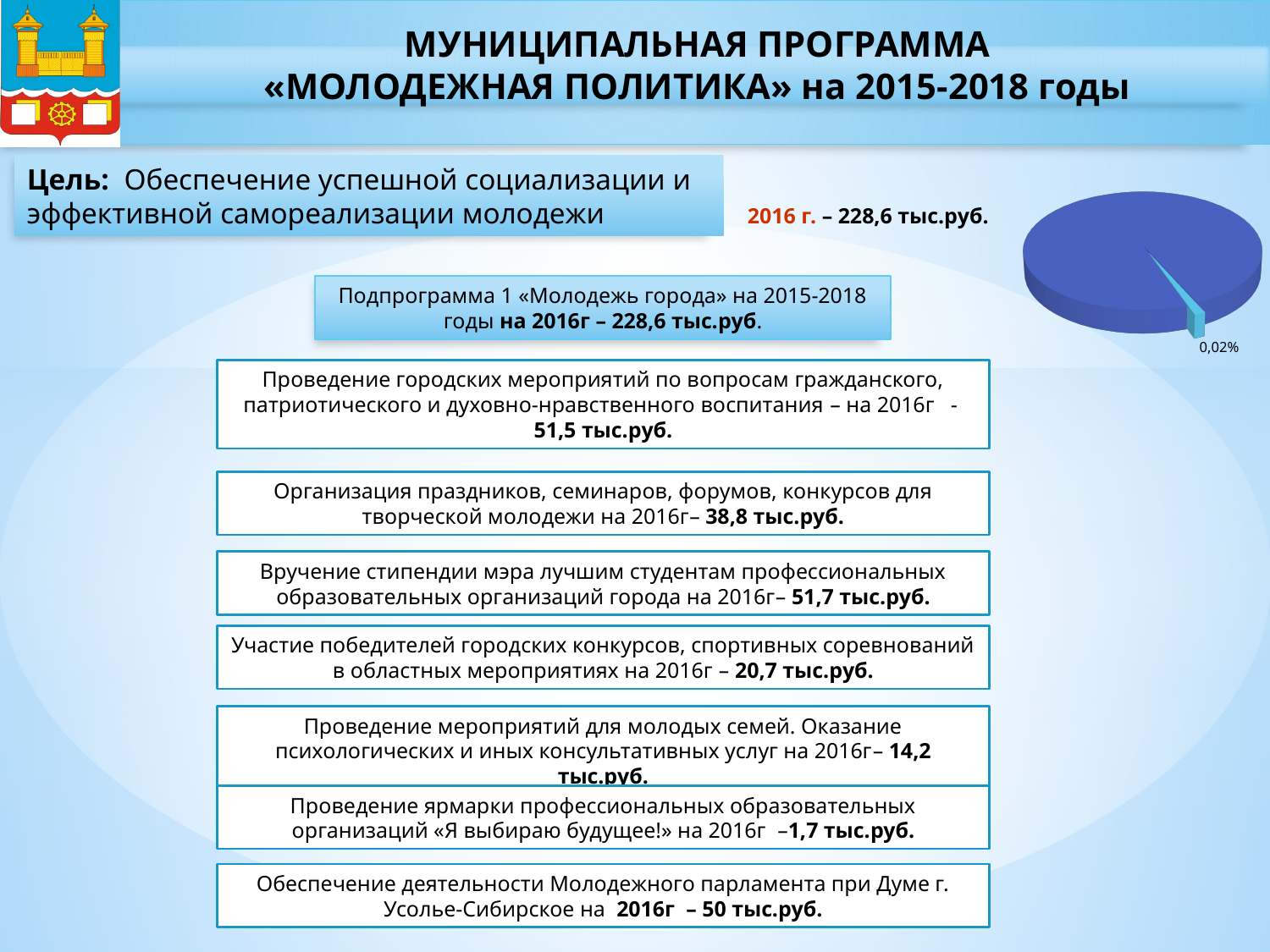
What kind of chart is shown on the right side of the slide? pie chart How many slices does the pie chart show? 2 Does the pie chart display a legend? No Is the slice labelled 0,02% the larger or the smaller slice of the pie chart? smaller What colour is the large slice of the pie chart? blue What share of the pie does the slice with the printed data label represent? 0,02% What percentage is printed as the data label on the small slice of the pie chart? 0,02%